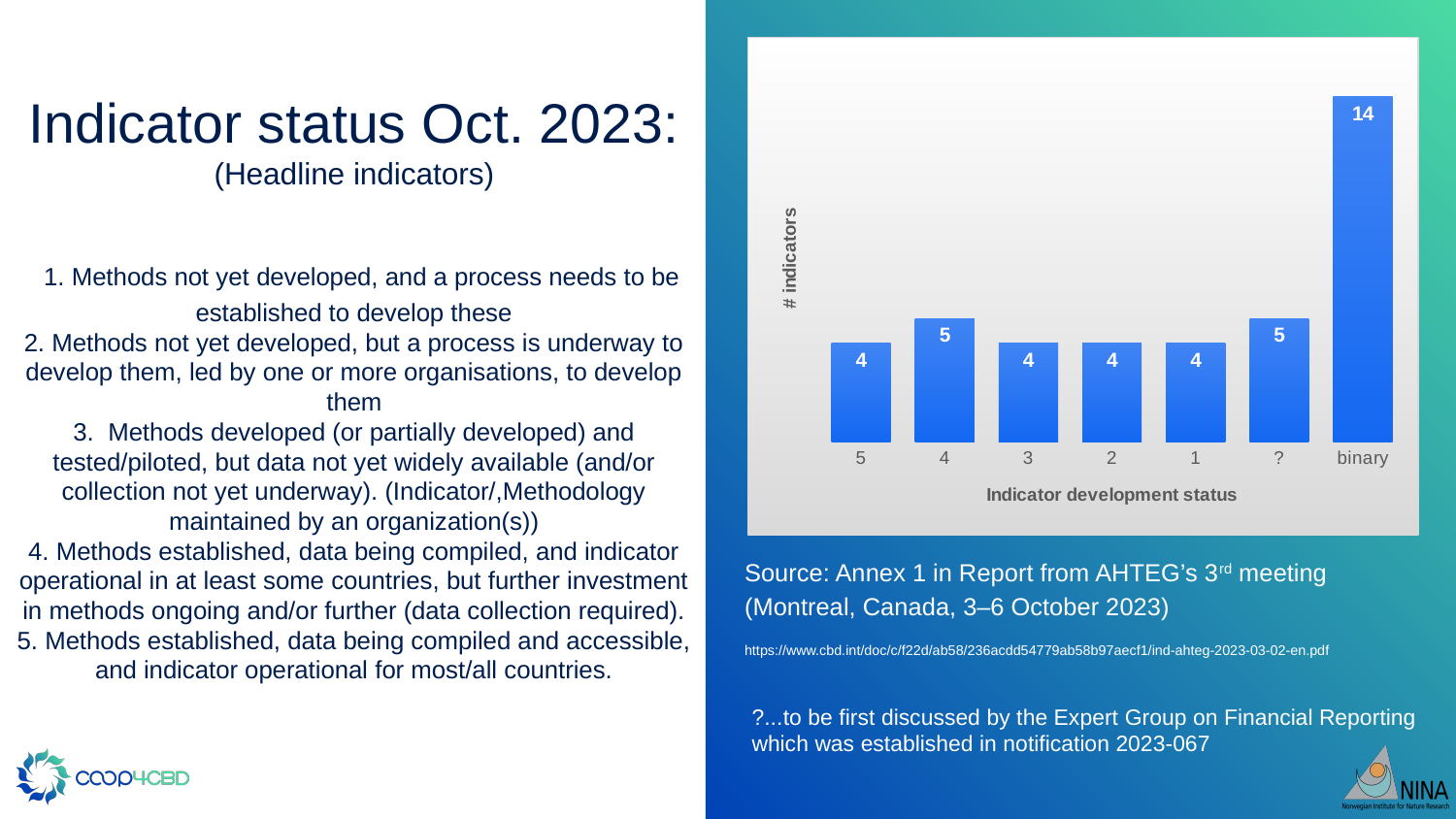
What is the number of indicators for development status 4? 5 What is the difference between the number of indicators for 'binary' and for status 4? 9 What is the number of indicators for development status 5? 4 How many categories are shown on the x axis? 7 Which category has the highest number of indicators? binary What is the difference between the number of indicators for status 4 and status 1? 1 What is the label of the y axis? # indicators How many indicators are in the 'binary' category? 14 What is the label of the x axis? Indicator development status What kind of chart is shown on the slide? bar chart Which has more indicators: status 4 or status 3? status 4 What is the number of indicators for the '?' category? 5